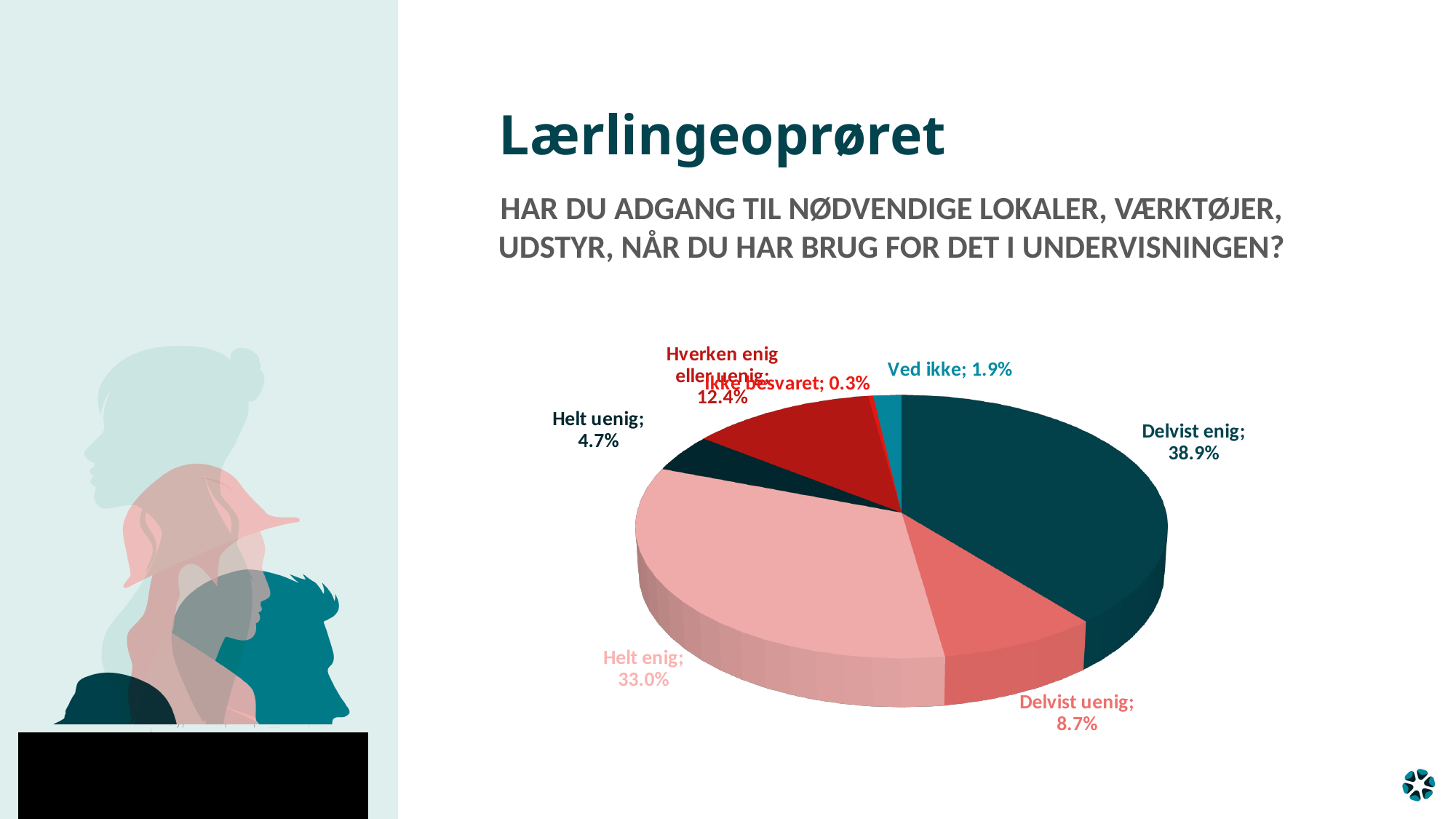
What kind of chart is shown on the slide? Pie chart Which category has the largest slice of the pie? Delvist enig Which is larger, "Delvist uenig" or "Helt uenig"? Delvist uenig What percentage is shown for "Ved ikke"? 1.9% What share of respondents answered "Delvist enig"? 38.9% What is the title of the slide above the chart? Lærlingeoprøret Which category has the smallest slice of the pie? Ikke besvaret What is the combined share of "Helt enig" and "Delvist enig"? 71.9% What share of respondents answered "Helt enig"? 33.0% What is the difference in percentage points between "Delvist enig" and "Helt enig"? 5.9 How many slices does the pie chart have? 7 What percentage is shown for "Hverken enig eller uenig"? 12.4%